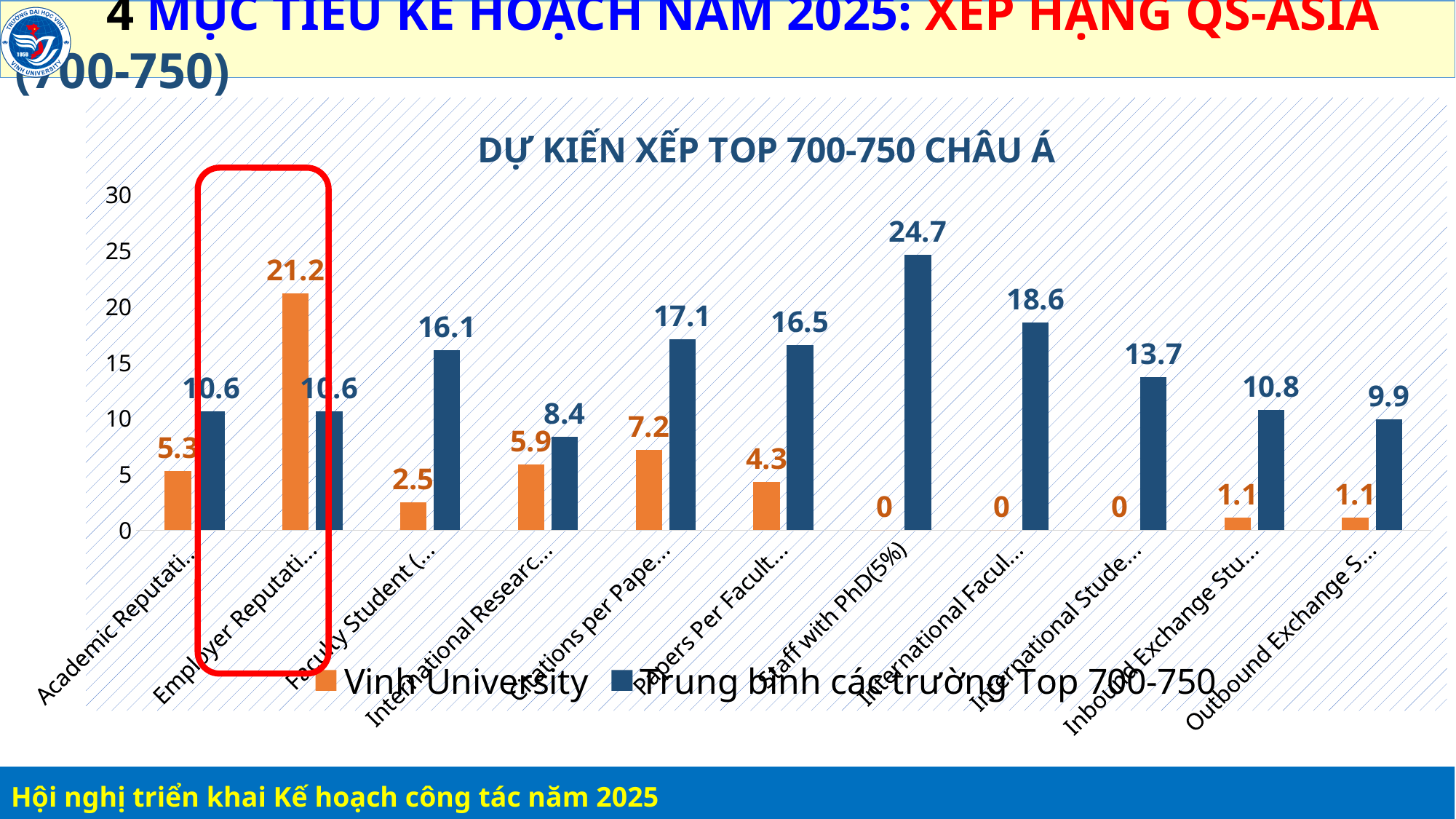
For Employer Reputation, how much higher is the Vinh University value than the Trung bình các trường Top 700-750 value? 10.6 How many categories are shown on the x axis of the chart? 11 Which category has the highest Trung bình các trường Top 700-750 value? Staff with PhD(5%) What is the difference between the Trung bình các trường Top 700-750 value and the Vinh University value for Staff with PhD(5%)? 24.7 Which category has the highest Vinh University value? Employer Reputation For Employer Reputation, which series has the larger value: Vinh University or Trung bình các trường Top 700-750? Vinh University What is the Vinh University value for Staff with PhD(5%)? 0 How many series does the legend list? 2 What kind of chart is shown on the slide? Bar chart What is the Trung bình các trường Top 700-750 value for Staff with PhD(5%)? 24.7 What is the title of the chart? DỰ KIẾN XẾP TOP 700-750 CHÂU Á What is the Vinh University value for Employer Reputation? 21.2